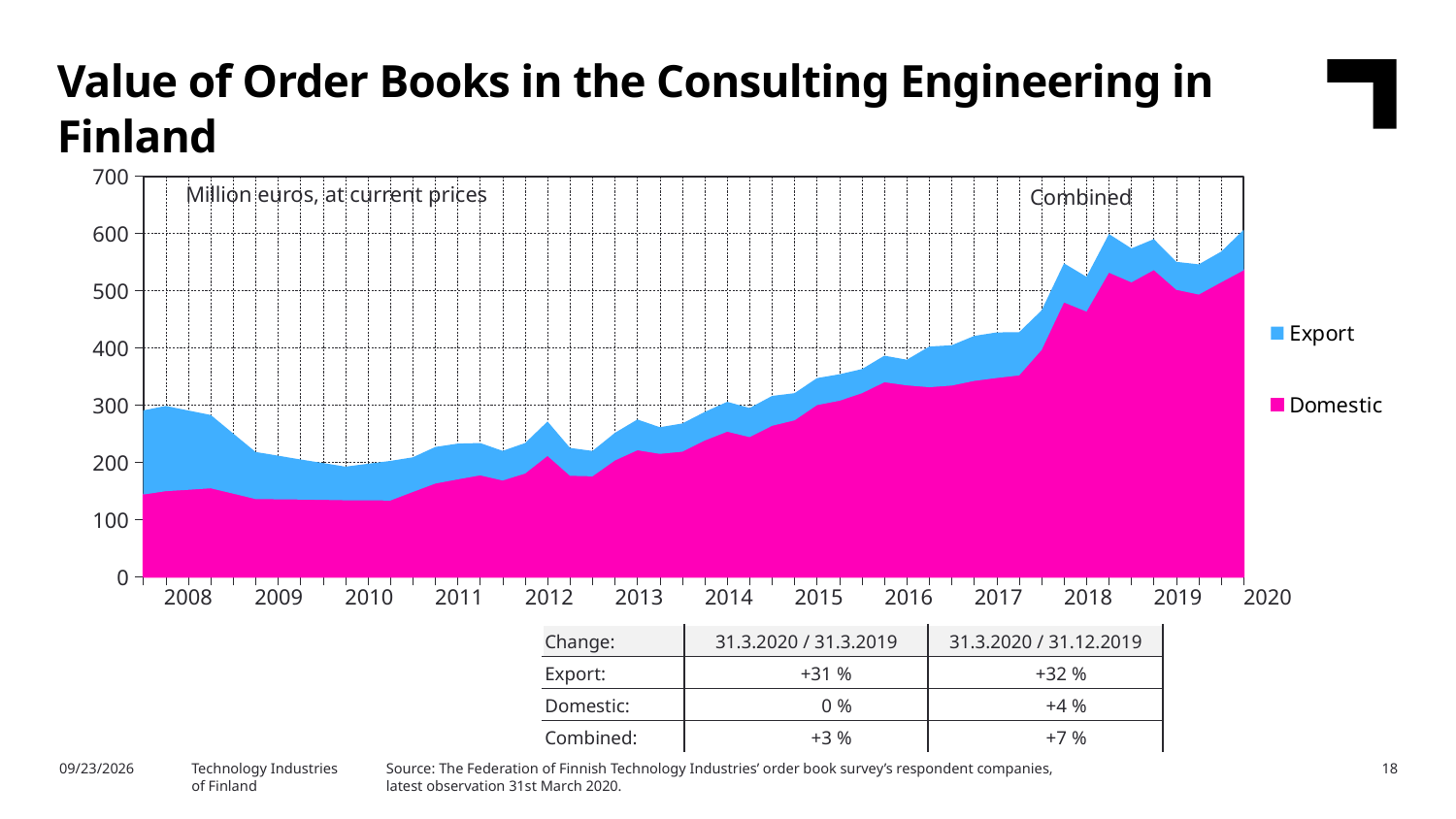
What type of chart is shown on the slide? Stacked area chart Is the Domestic value in 2010 greater or less than 200? less How many year labels are shown on the x axis of the chart? 13 In what unit are the values on the chart expressed, according to the label inside the plot area? Million euros, at current prices At the start of 2020, which series is larger, Export or Domestic? Domestic How many series does the chart legend list? 2 According to the table below the chart, what is the change in Export order books for 31.3.2020 / 31.3.2019? +31 % Which two series are listed in the chart legend? Export and Domestic Is the combined value at the start of 2020 greater or less than 500? greater Does the combined value of order books generally rise or fall from 2008 to 2020? Rise According to the table below the chart, what is the change in Combined order books for 31.3.2020 / 31.12.2019? +7 % Is the combined value in 2016 greater or less than 300? greater